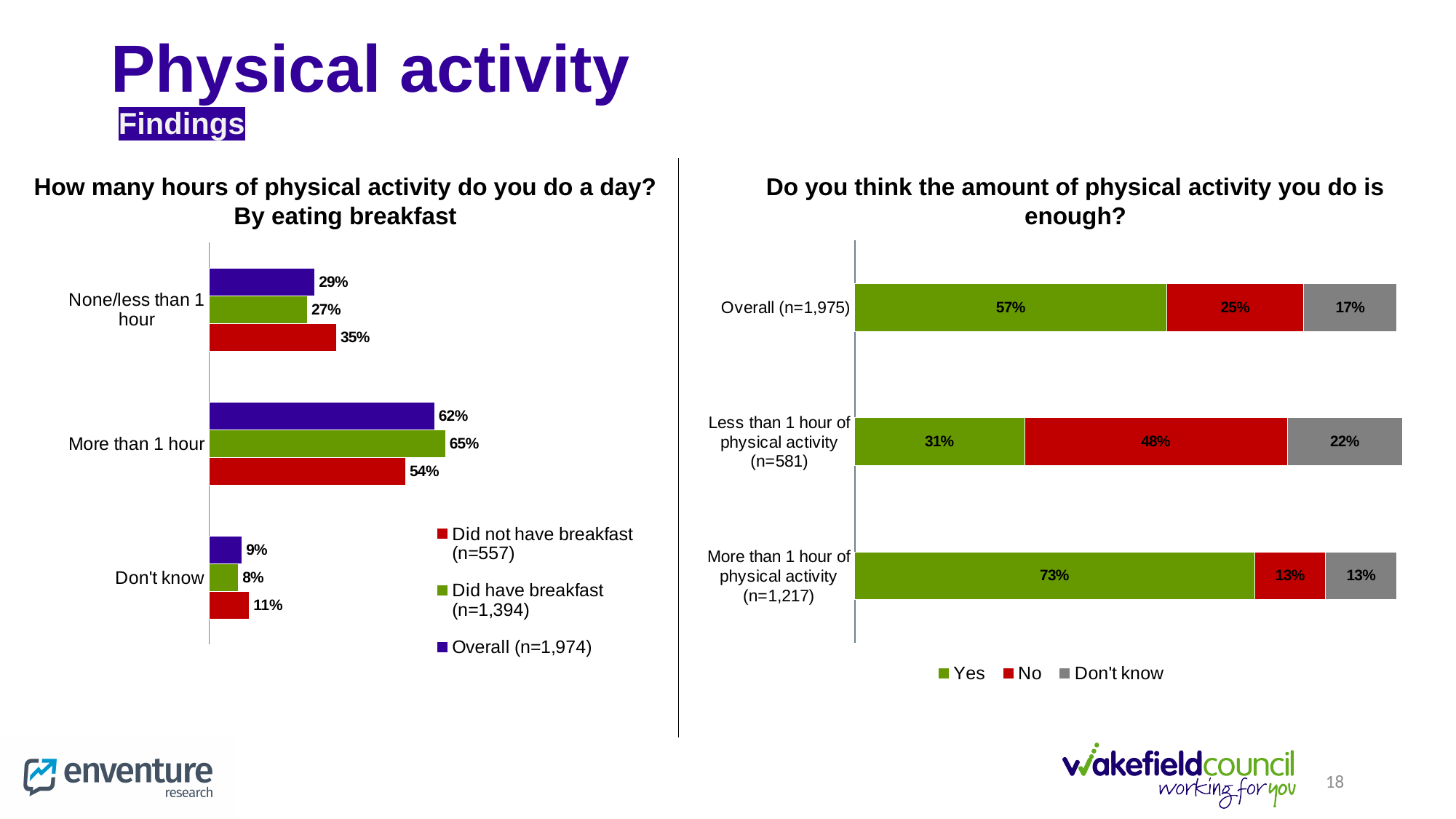
In the left chart 'How many hours of physical activity do you do a day? By eating breakfast', what is the 'Overall' value for 'More than 1 hour'? 62% In the left chart 'How many hours of physical activity do you do a day? By eating breakfast', how many categories are shown? 3 In the left chart 'How many hours of physical activity do you do a day? By eating breakfast', what is the difference between 'Did have breakfast' and 'Did not have breakfast' for 'More than 1 hour'? 11% In the right chart 'Do you think the amount of physical activity you do is enough?', what is the total of the stacked bar for 'More than 1 hour of physical activity (n=1,217)'? 99% In the left chart 'How many hours of physical activity do you do a day? By eating breakfast', which series has the highest value for 'More than 1 hour'? Did have breakfast (n=1,394) In the right chart 'Do you think the amount of physical activity you do is enough?', which group has the highest 'Yes' value? More than 1 hour of physical activity (n=1,217) What kind of chart is the right chart 'Do you think the amount of physical activity you do is enough?'? Stacked bar chart In the left chart 'How many hours of physical activity do you do a day? By eating breakfast', what is the value for 'Did not have breakfast' in the 'None/less than 1 hour' category? 35% In the right chart 'Do you think the amount of physical activity you do is enough?', is the 'Yes' value larger for 'Overall (n=1,975)' or for 'Less than 1 hour of physical activity (n=581)'? Overall (n=1,975) In the right chart 'Do you think the amount of physical activity you do is enough?', what percentage of the 'Less than 1 hour of physical activity (n=581)' group answered 'No'? 48% In the right chart 'Do you think the amount of physical activity you do is enough?', what percentage of the 'Overall (n=1,975)' group answered 'Yes'? 57% In the left chart 'How many hours of physical activity do you do a day? By eating breakfast', how many series does the legend list? 3